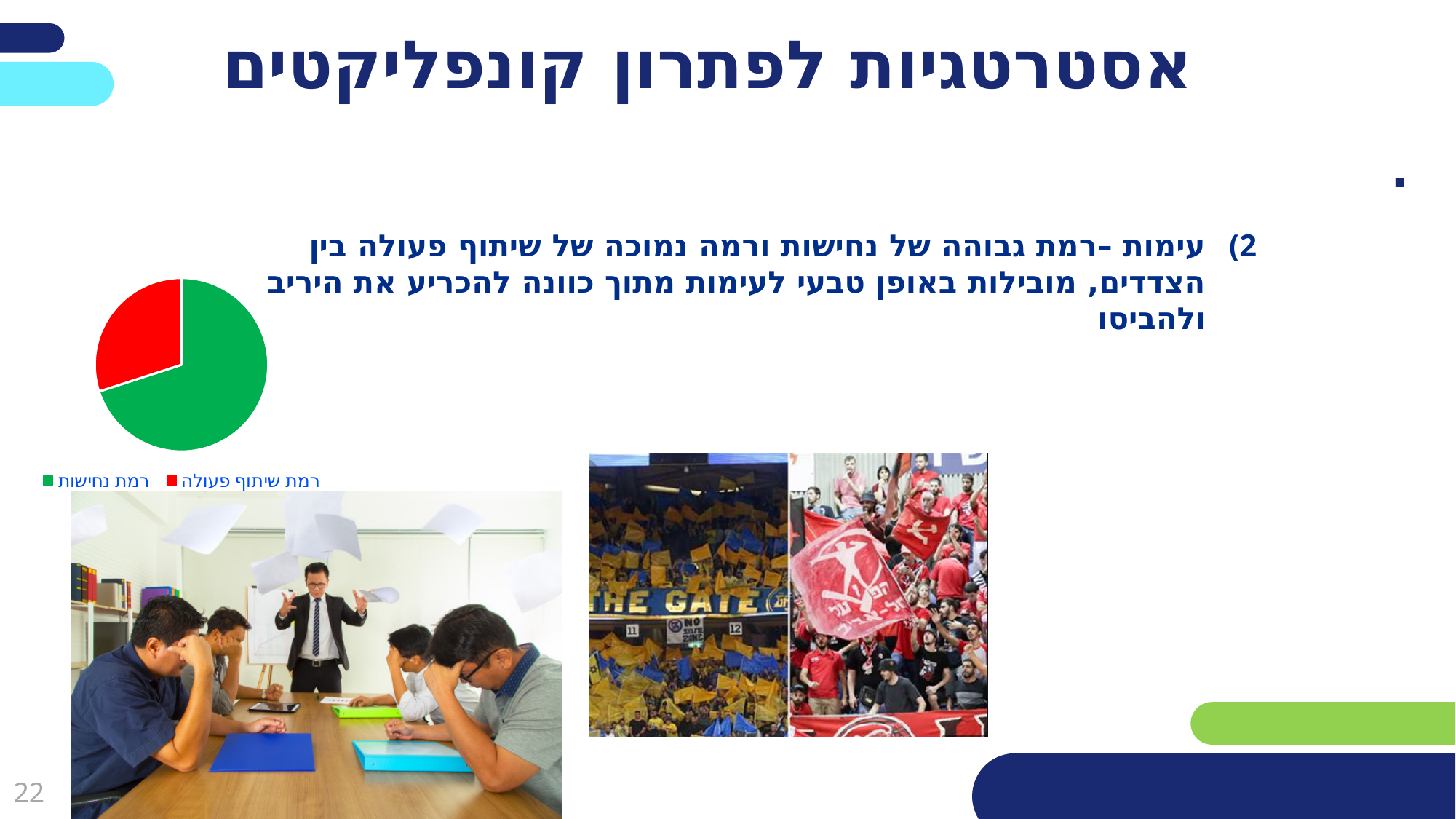
Which category has the largest slice in the pie chart? רמת נחישות How many entries does the legend of the pie chart list? 2 How many slices does the pie chart have? 2 What colour is the slice for רמת נחישות in the pie chart? green What colour is the slice for רמת שיתוף פעולה in the pie chart? red Which slice is larger in the pie chart, רמת נחישות or רמת שיתוף פעולה? רמת נחישות Which category has the smallest slice in the pie chart? רמת שיתוף פעולה What kind of chart is shown on the slide? pie chart